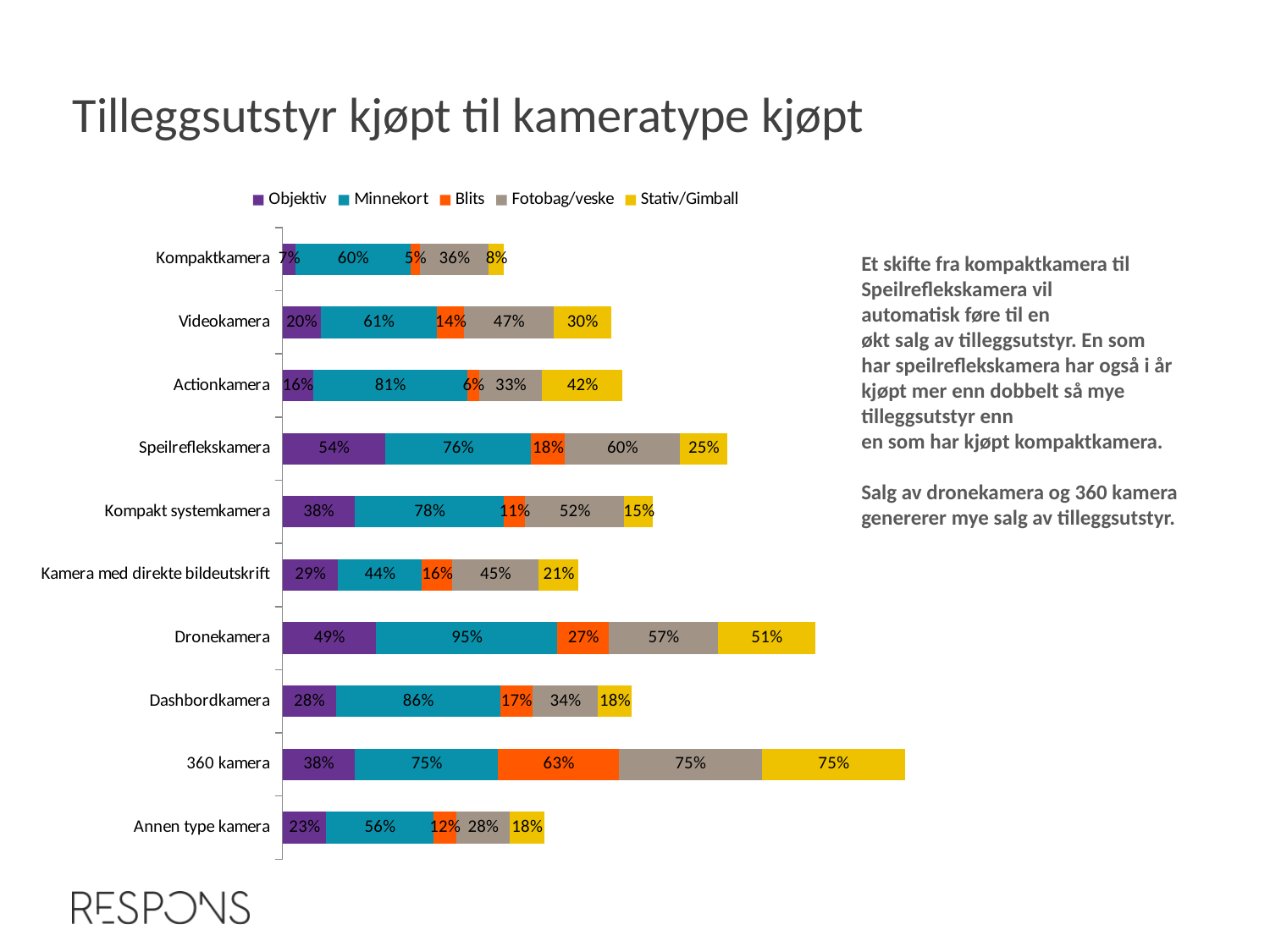
What is the Blits value for 360 kamera? 63% What is the Fotobag/veske value for Speilreflekskamera? 60% What is the Stativ/Gimball value for Actionkamera? 42% Which is larger, the Stativ/Gimball value for Dronekamera or for Videokamera? Dronekamera How many series does the legend list? 5 Which camera type has the lowest Minnekort value? Kamera med direkte bildeutskrift What is the difference between the Objektiv values for Speilreflekskamera and Kompaktkamera? 47% How many camera types are shown on the chart? 10 Which camera type has the highest Objektiv value? Speilreflekskamera What is the Minnekort value for Dronekamera? 95% What is the total of the stacked bar for Kompaktkamera? 116% What kind of chart is shown on the slide? Stacked bar chart